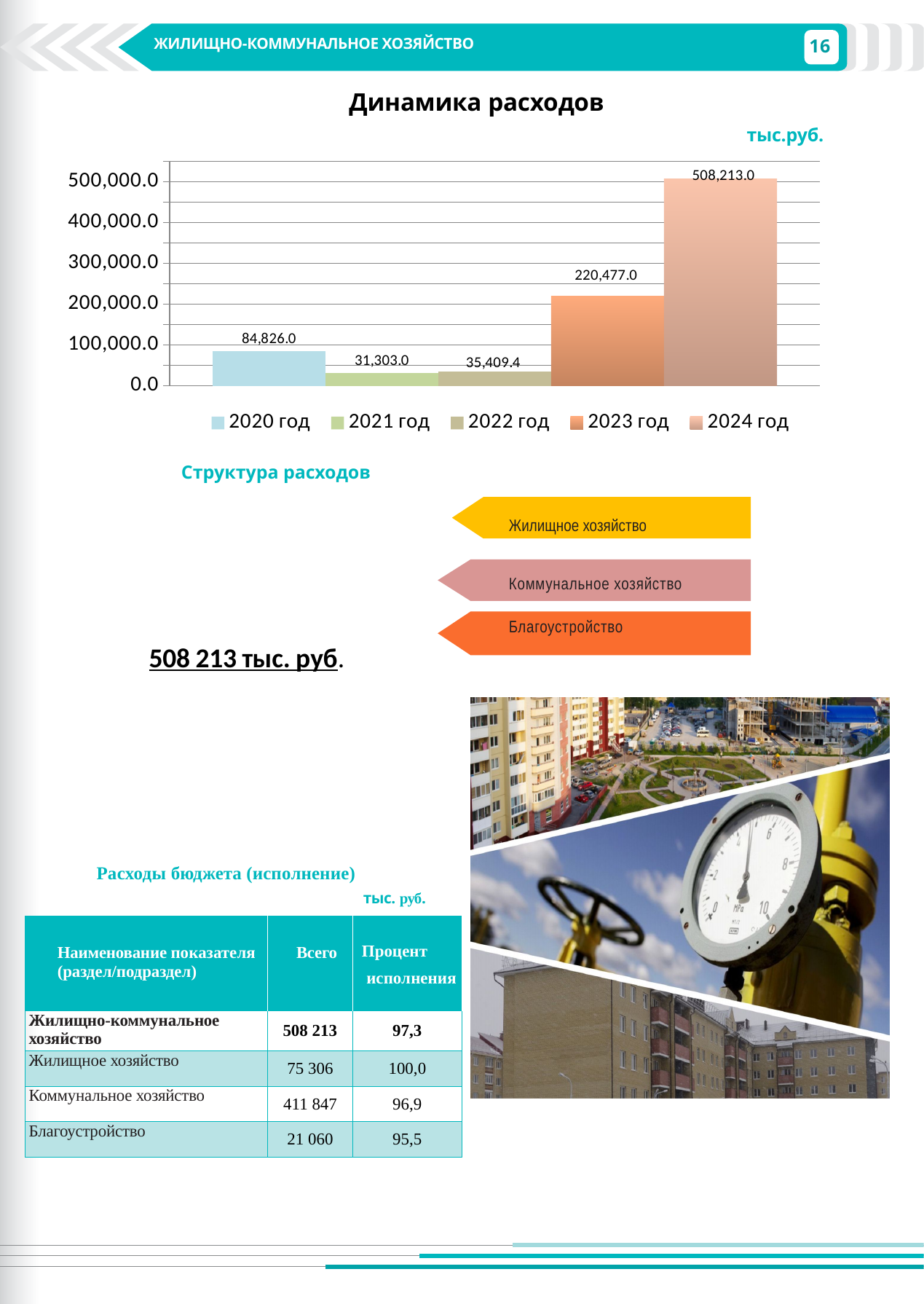
What is the value for 2022 год in the Динамика расходов chart? 35,409.4 What kind of chart is Динамика расходов? bar chart Is the value for 2023 год in the Динамика расходов chart greater or less than 200,000.0? greater What is the difference between the values for 2024 год and 2023 год in the Динамика расходов chart? 287,736.0 Which is larger in the Динамика расходов chart, the value for 2020 год or 2022 год? 2020 год What is the value for 2020 год in the Динамика расходов chart? 84,826.0 What is the value for 2024 год in the Динамика расходов chart? 508,213.0 Which year has the highest value in the Динамика расходов chart? 2024 год Which year has the lowest value in the Динамика расходов chart? 2021 год How many series does the legend of the Динамика расходов chart list? 5 What unit is shown above the Динамика расходов chart? тыс.руб. What is the difference between the values for 2022 год and 2021 год in the Динамика расходов chart? 4,106.4